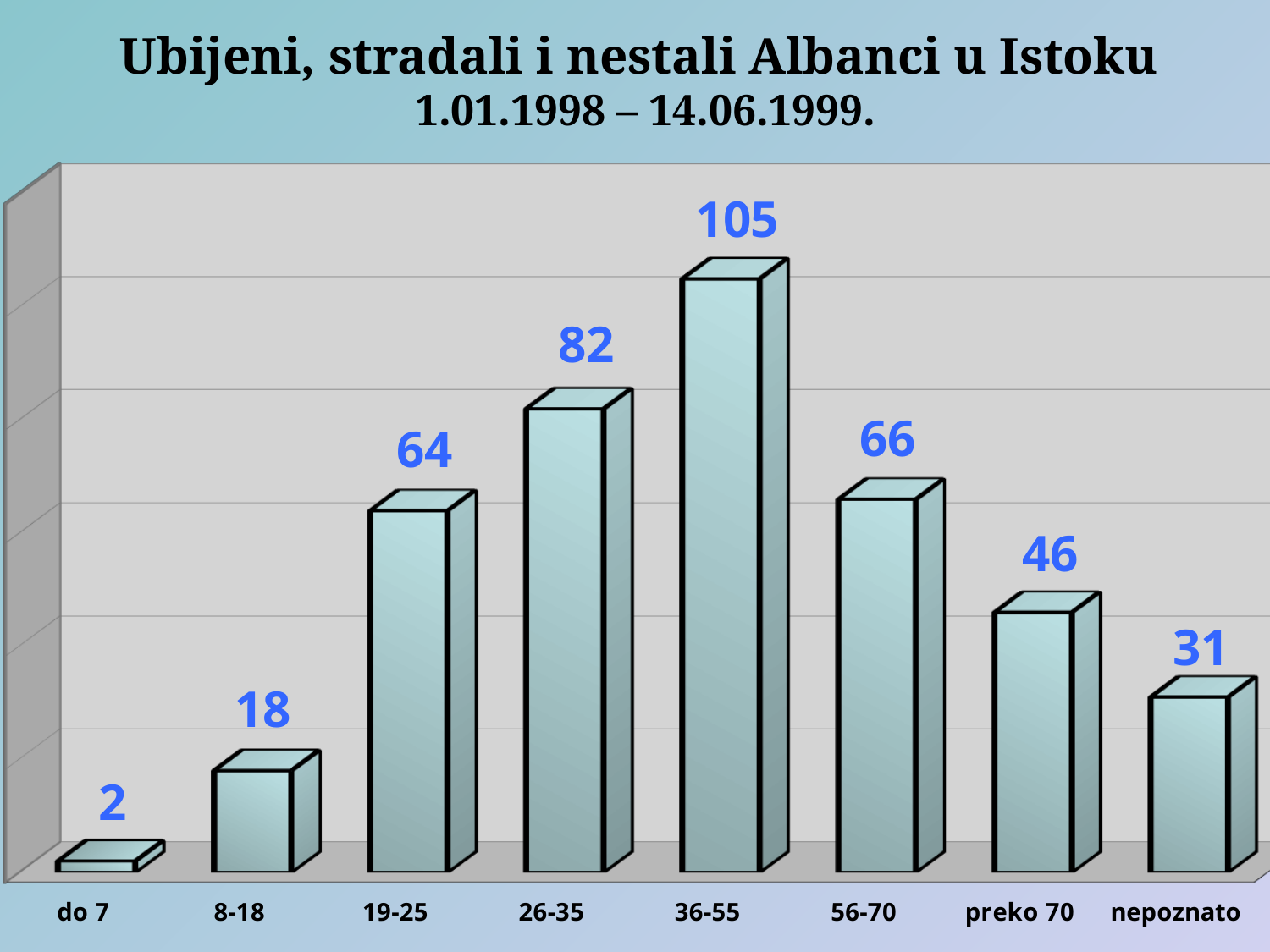
Which age group has the highest value? 36-55 Which category has the lowest value? do 7 Which is larger, the value for 19-25 or the value for 56-70? 56-70 Do the values rise or fall from 'do 7' to 36-55? rise How many categories are shown on the x axis? 8 What is the value for the 'do 7' age group? 2 What is the difference between the values for 36-55 and 26-35? 23 What is the date range given in the chart title? 1.01.1998 – 14.06.1999. What is the difference between the values for 56-70 and 'preko 70'? 20 What kind of chart is shown on the slide? bar chart What is the value for the 36-55 age group? 105 What is the value for the 'nepoznato' category? 31